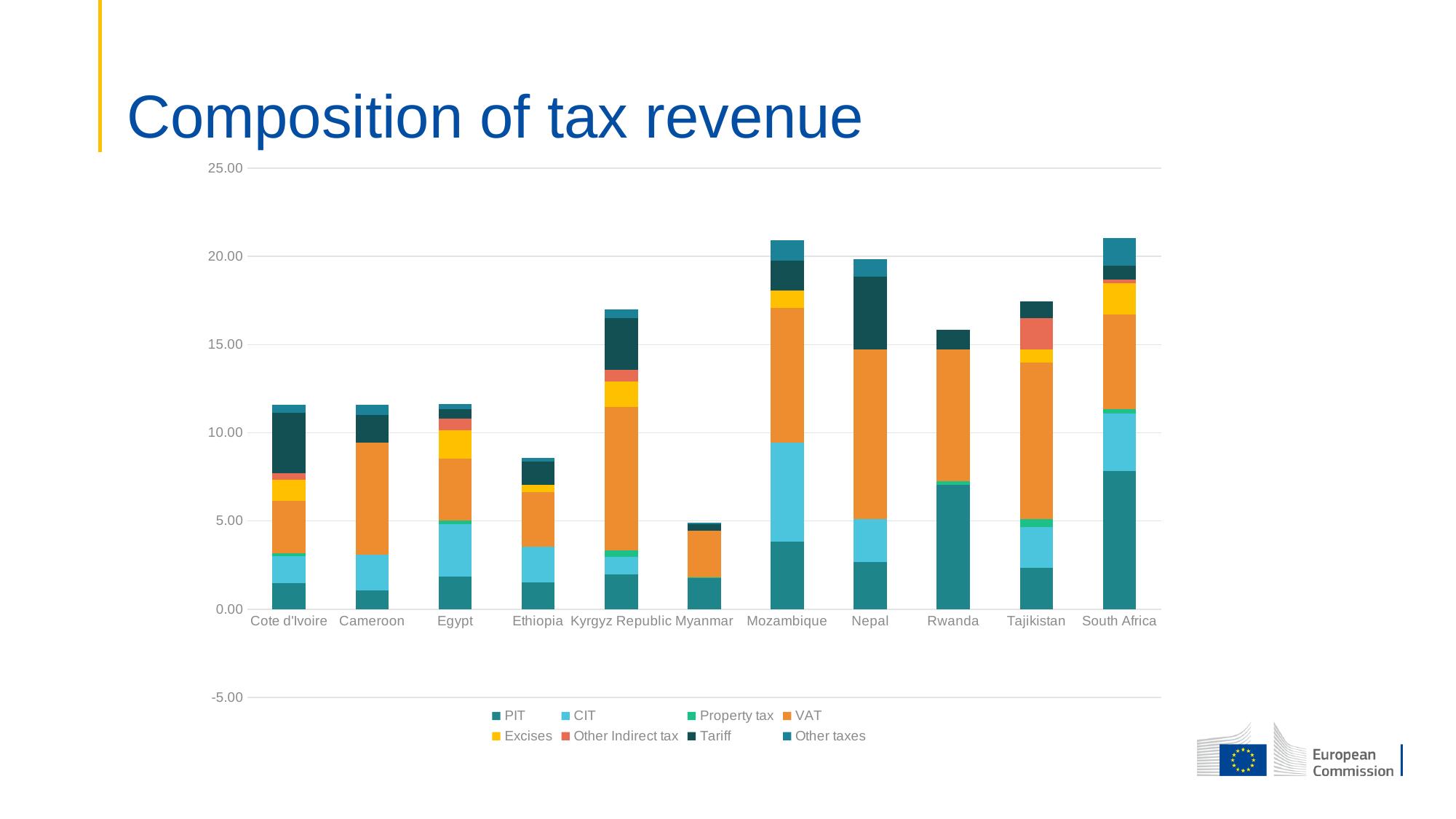
Is the total bar for Mozambique greater or less than 20.00? greater Is the total bar for Ethiopia greater or less than 10.00? less Which has the larger total bar, Kyrgyz Republic or Myanmar? Kyrgyz Republic Which country has the largest CIT segment? Mozambique Is the total bar for Cote d'Ivoire greater or less than 10.00? greater Which country has the lowest total tax revenue bar? Myanmar What kind of chart is shown on the slide? Stacked bar chart What is the title of the chart? Composition of tax revenue How many countries are shown on the x axis of the chart? 11 How many series does the legend list? 8 Which has the larger total bar, Rwanda or Ethiopia? Rwanda